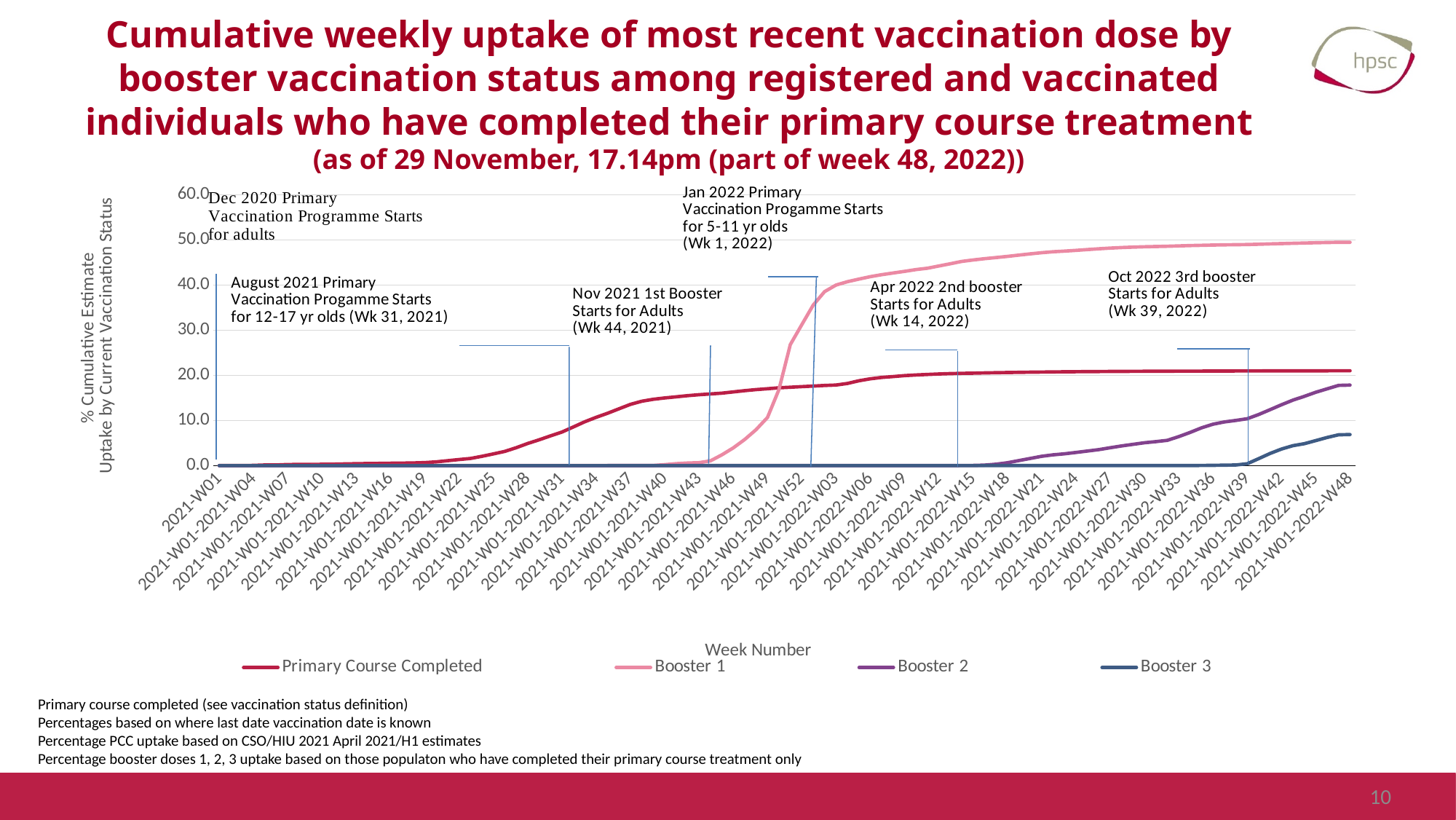
Is the value for Booster 1 at 2022-W48 greater or less than 40? greater Is the value for Booster 3 at 2022-W48 greater or less than 10? less Does the Booster 1 series rise or fall along the x axis? rise How many series does the legend list? 4 What kind of chart is shown on the slide? line chart At 2022-W48, which is larger: Booster 1 or Primary Course Completed? Booster 1 Which series has the lowest value at 2022-W48? Booster 3 Is the value for Booster 2 at 2022-W33 greater or less than 10? less Which series has the highest value at 2022-W48? Booster 1 What is the title of the x axis? Week Number At 2022-W48, which is larger: Booster 2 or Booster 3? Booster 2